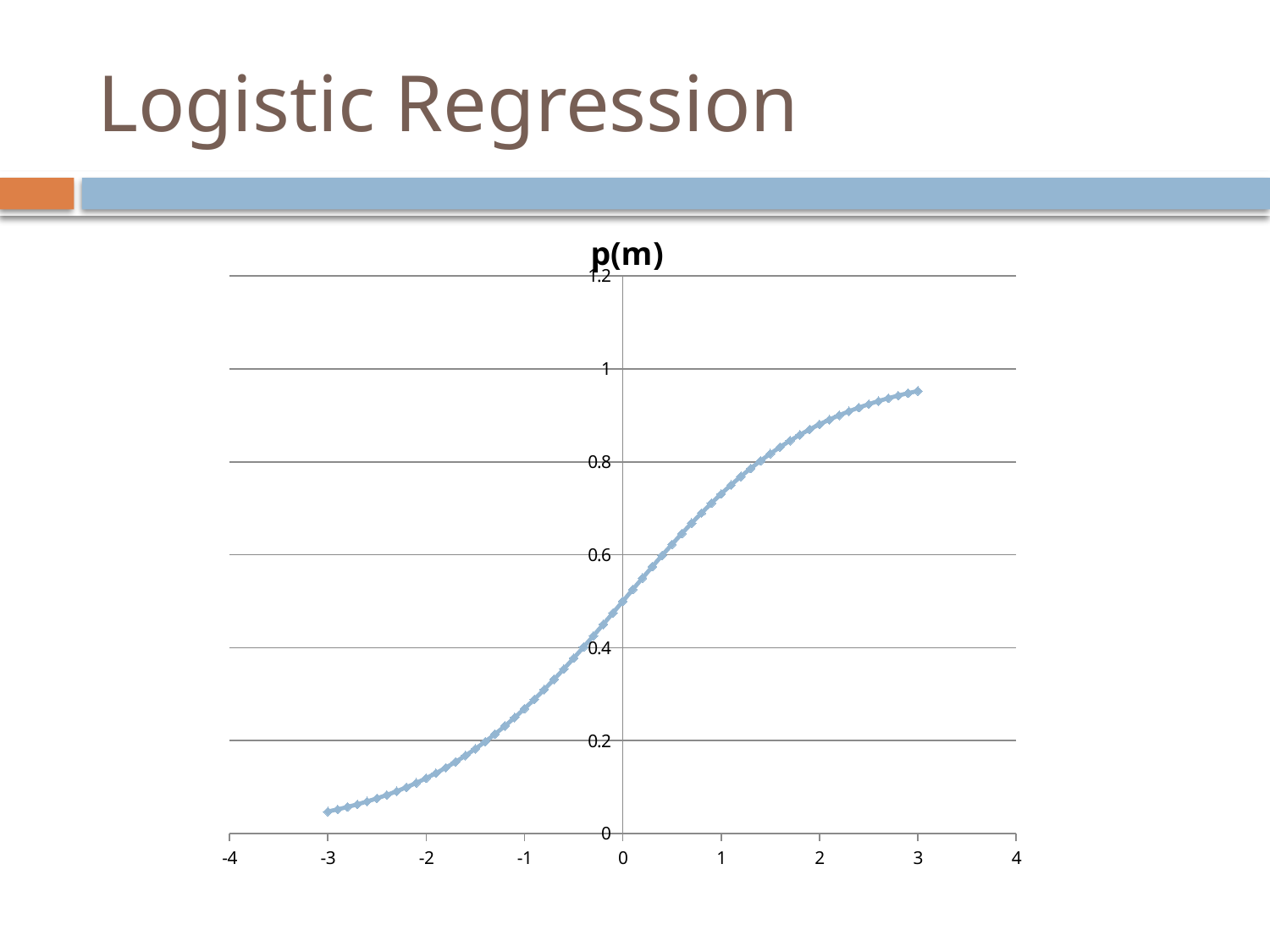
What is the title of the chart? p(m) Do the plotted values rise or fall as m increases along the x axis? rise At which value of m does the plotted curve reach its lowest point? -3 Is the value of p(m) at m = -3 greater or less than 0.2? less Is the value of p(m) at m = 2 greater or less than 1? less Is the value of p(m) at m = 1 greater or less than 0.6? greater What kind of chart is shown on the slide? line chart Which is larger, the value of p(m) at m = 2 or at m = -2? m = 2 At which value of m does the plotted curve reach its highest point? 3